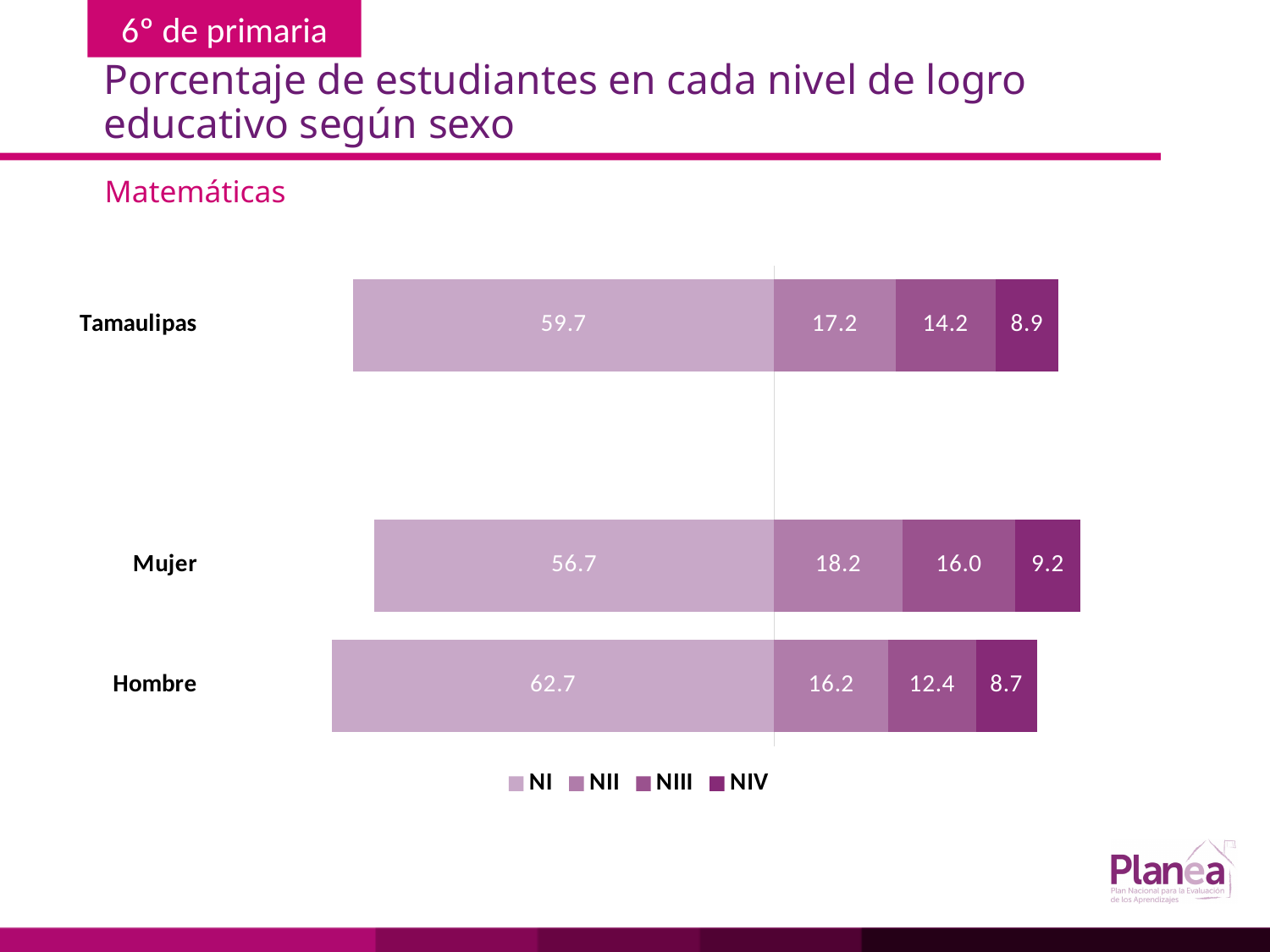
What is the difference between the NI values for Hombre and Mujer? 6.0 Which category has the highest NI value? Hombre What is the NIV value for Mujer? 9.2 What is the NI value for Hombre? 62.7 What is the total of the stacked bar for Tamaulipas? 100.0 How many categories are shown on the chart? 3 Which is larger, the NII value for Mujer or the NII value for Tamaulipas? Mujer Which category has the lowest NIII value? Hombre How many series does the legend list? 4 What is the NII value for Hombre? 16.2 What kind of chart is shown on the slide? Stacked bar chart What is the NIII value for Tamaulipas? 14.2